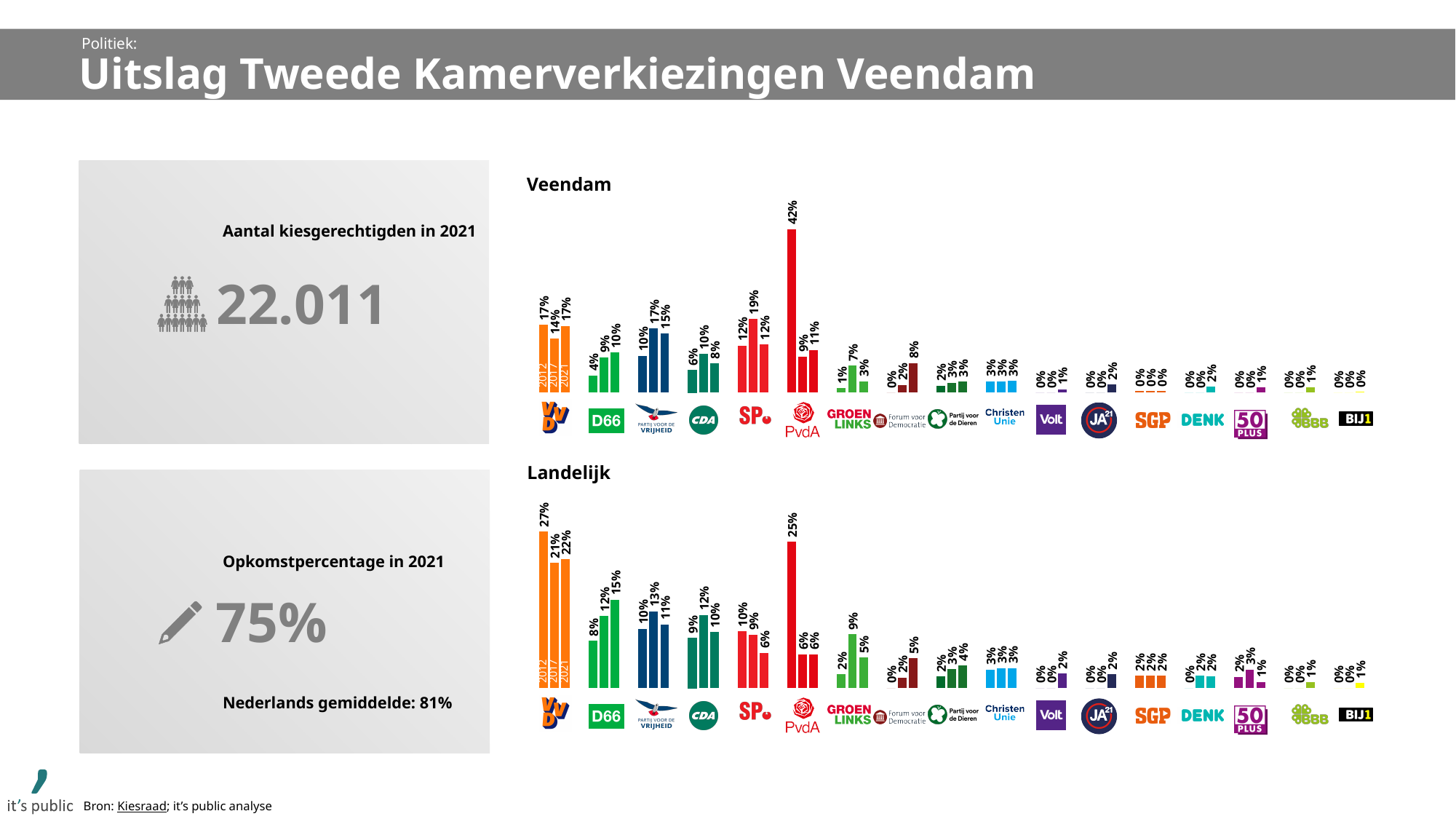
What kind of chart is the Veendam chart? bar chart How many parties are shown in the Landelijk chart? 17 In the Veendam chart, which is larger: the VVD's 2021 value or the PVV's 2021 value? VVD's 2021 value In the Veendam chart, what percentage did the SP get in 2017? 19% In the Landelijk chart, what percentage did D66 get in 2021? 15% In the Veendam chart, what is the difference between the PvdA's 2012 and 2017 percentages? 33% In the Veendam chart, what percentage did the PvdA get in 2012? 42% In the Landelijk chart, what is the difference between the VVD's 2012 and 2021 percentages? 5% In the Veendam chart, which party has the highest single bar? PvdA In the Landelijk chart, did the SP's percentage rise or fall from 2012 to 2021? fall In the Veendam chart, did D66's percentage rise or fall from 2012 to 2021? rise In the Landelijk chart, what percentage did the VVD get in 2012? 27%